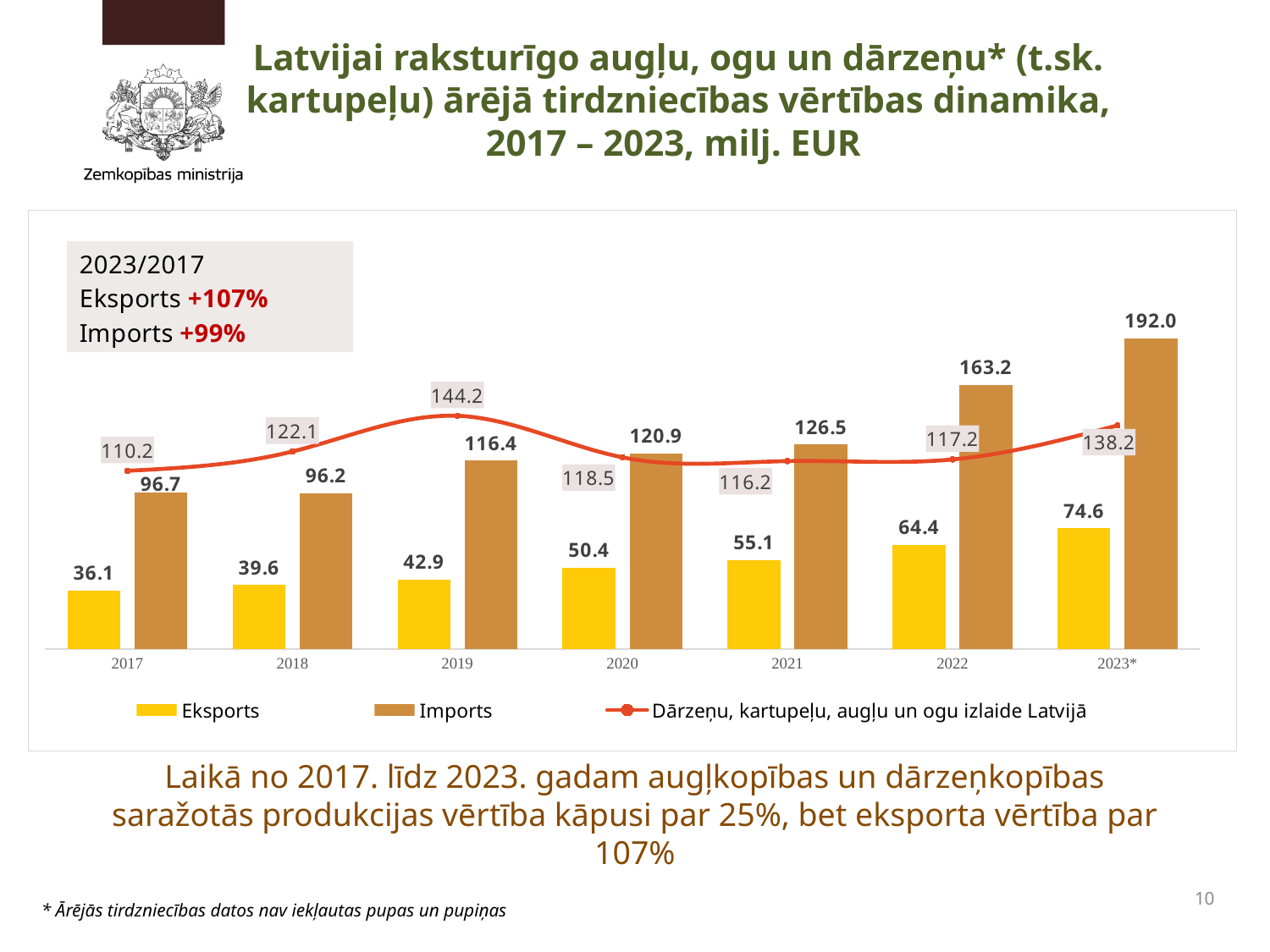
Which is larger in 2020: the Imports value or the line value for 'Dārzeņu, kartupeļu, augļu un ogu izlaide Latvijā'? Imports What is the difference between the Imports and Eksports values in 2022? 98.8 What is the Eksports value for 2017? 36.1 What colour are the Eksports bars? Yellow What is the Imports value for 2023*? 192.0 Do the Eksports values rise or fall from 2017 to 2023*? Rise What is the value of the line series 'Dārzeņu, kartupeļu, augļu un ogu izlaide Latvijā' for 2019? 144.2 How many years are shown on the x axis? 7 What kind of chart is this? Combined bar and line chart In which year is the Imports value highest? 2023* How many series does the legend list? 3 In which year is the Eksports value lowest? 2017